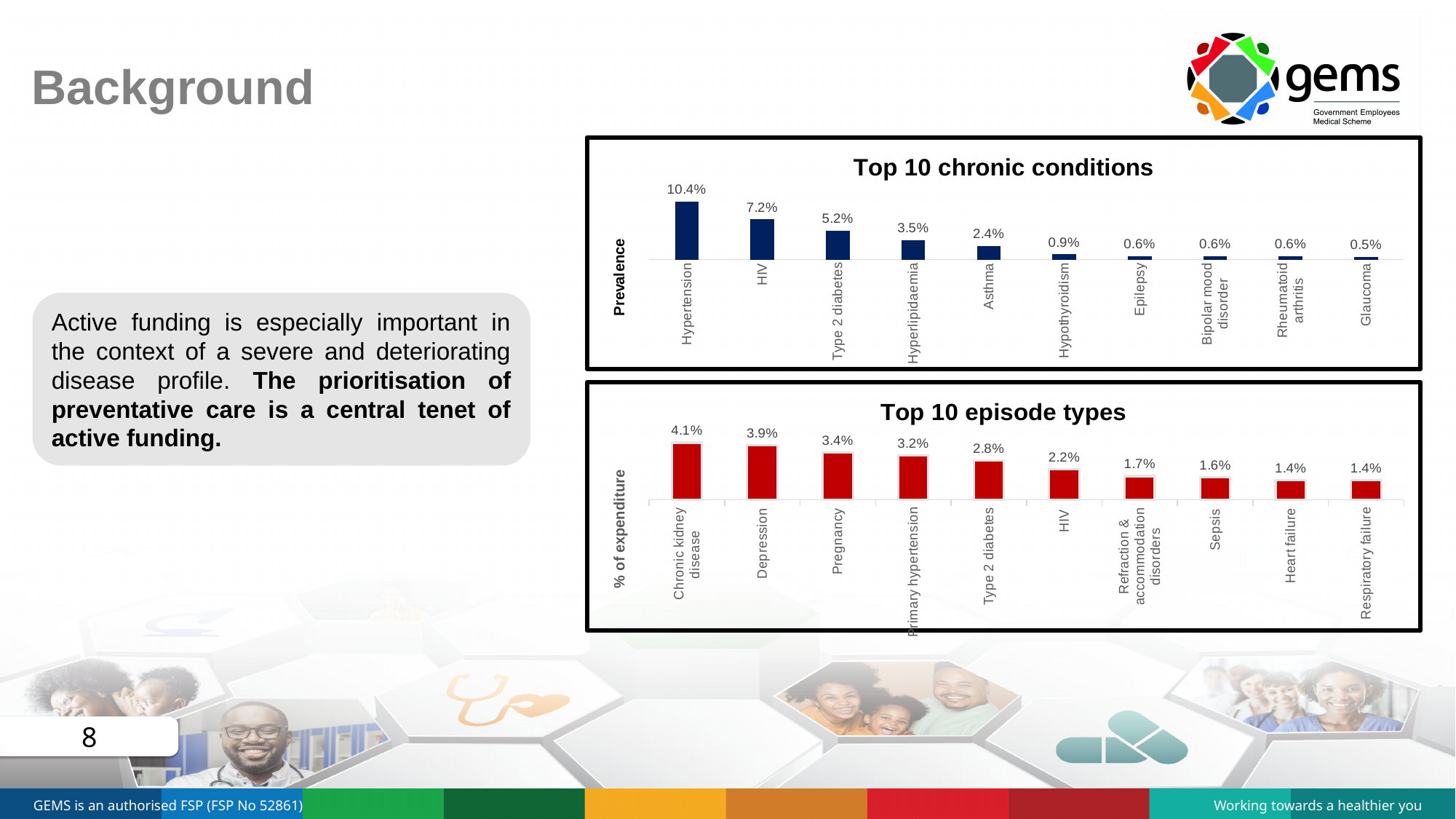
In the 'Top 10 episode types' chart, what is the difference between Chronic kidney disease and Type 2 diabetes? 1.3% In the 'Top 10 episode types' chart, what is the % of expenditure for Pregnancy? 3.4% In the 'Top 10 chronic conditions' chart, how many conditions are shown? 10 In the 'Top 10 chronic conditions' chart, what is the prevalence of Hypertension? 10.4% In the 'Top 10 chronic conditions' chart, do the values rise or fall from left to right? fall In the 'Top 10 episode types' chart, what is the % of expenditure for Sepsis? 1.6% In the 'Top 10 episode types' chart, which episode type has the highest % of expenditure? Chronic kidney disease In the 'Top 10 episode types' chart, which is larger: the value for Depression or the value for HIV? Depression In the 'Top 10 chronic conditions' chart, what is the difference in prevalence between Hypertension and HIV? 3.2% In the 'Top 10 chronic conditions' chart, which condition has the lowest prevalence? Glaucoma What type of chart is the 'Top 10 episode types' chart? bar chart In the 'Top 10 chronic conditions' chart, what is the prevalence of Asthma? 2.4%